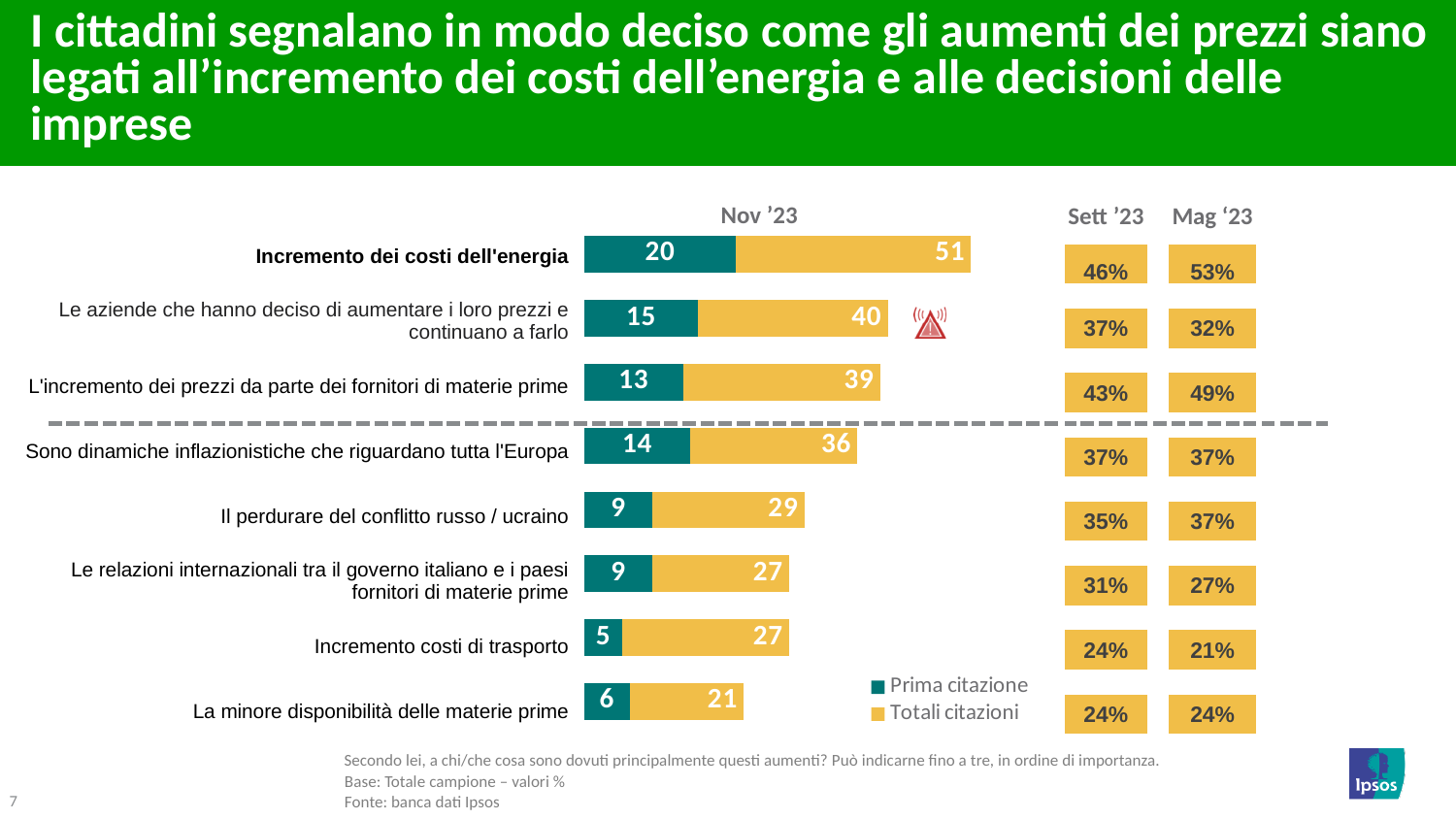
Which category has the highest Totali citazioni value? Incremento dei costi dell'energia Which has the larger Prima citazione value: "Sono dinamiche inflazionistiche che riguardano tutta l'Europa" or "L'incremento dei prezzi da parte dei fornitori di materie prime"? Sono dinamiche inflazionistiche che riguardano tutta l'Europa What is the Totali citazioni value for "Incremento dei costi dell'energia" in the Nov '23 chart? 51 What is the Totali citazioni value for "La minore disponibilità delle materie prime"? 21 How many categories are shown in the bar chart? 8 Which category has the lowest Prima citazione value? Incremento costi di trasporto What are the two legend entries of the chart? Prima citazione and Totali citazioni What is the difference between the Totali citazioni values for "Incremento dei costi dell'energia" and "Le aziende che hanno deciso di aumentare i loro prezzi e continuano a farlo"? 11 What is the difference between the Prima citazione values for "Incremento dei costi dell'energia" and "Incremento costi di trasporto"? 15 How many series does the legend list? 2 What kind of chart is shown on the slide? Bar chart What is the Prima citazione value for "Il perdurare del conflitto russo / ucraino"? 9